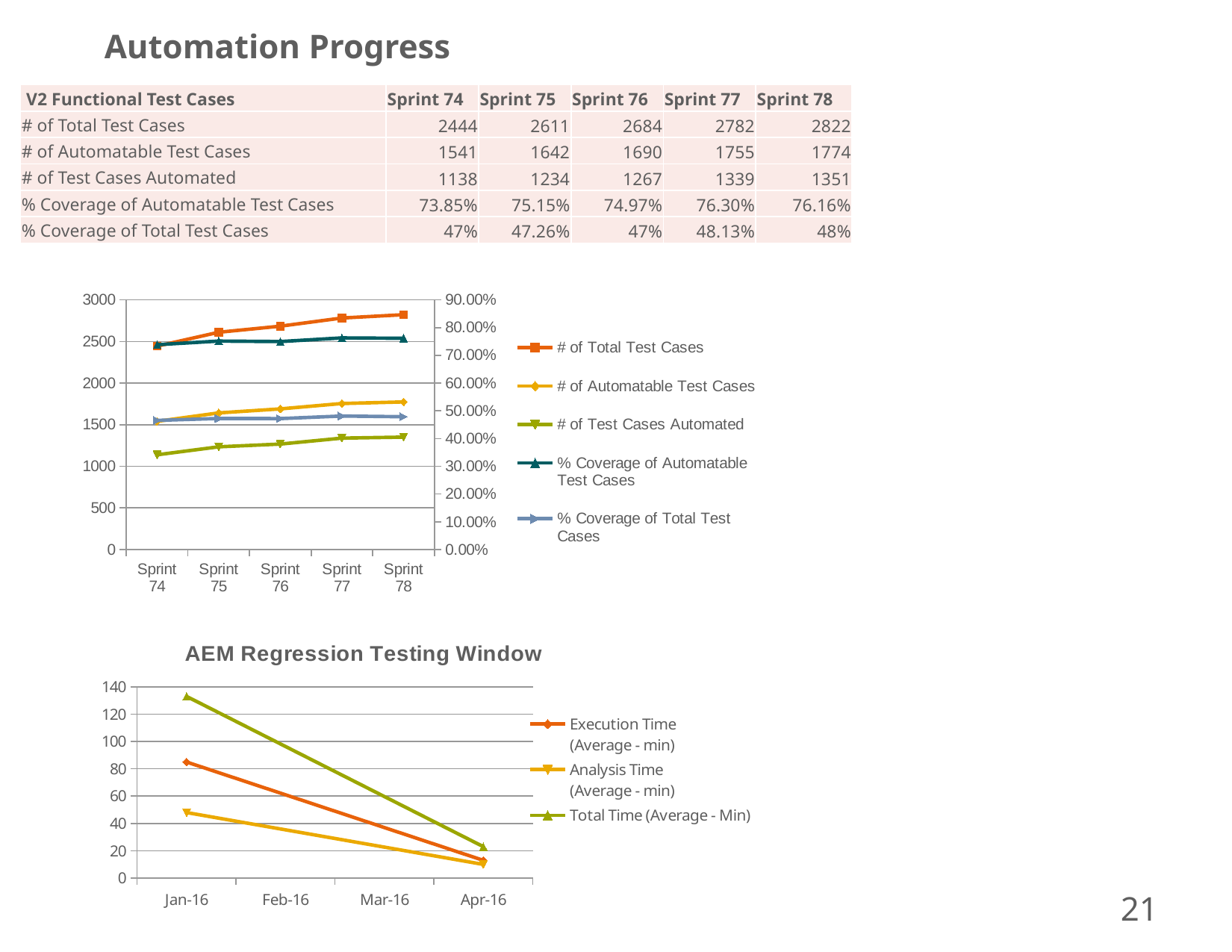
What is the title of the lower chart? AEM Regression Testing Window In the AEM Regression Testing Window chart, which is larger at Jan-16: Total Time (Average - Min) or Execution Time (Average - min)? Total Time (Average - Min) In the upper chart, what is the value of # of Test Cases Automated at Sprint 74? 1138 What kind of chart is the upper chart on the slide? line chart In the AEM Regression Testing Window chart, is the value for Total Time (Average - Min) at Jan-16 greater or less than 120? greater In the upper chart, what is the difference in # of Total Test Cases between Sprint 78 and Sprint 74? 378 In the upper chart, at which sprint is # of Total Test Cases highest? Sprint 78 How many sprints are shown on the x axis of the upper chart? 5 In the upper chart, does # of Total Test Cases rise or fall from Sprint 74 to Sprint 78? rise How many series does the legend of the upper chart list? 5 How many series does the legend of the AEM Regression Testing Window chart list? 3 In the upper chart, what is the value of # of Total Test Cases at Sprint 78? 2822